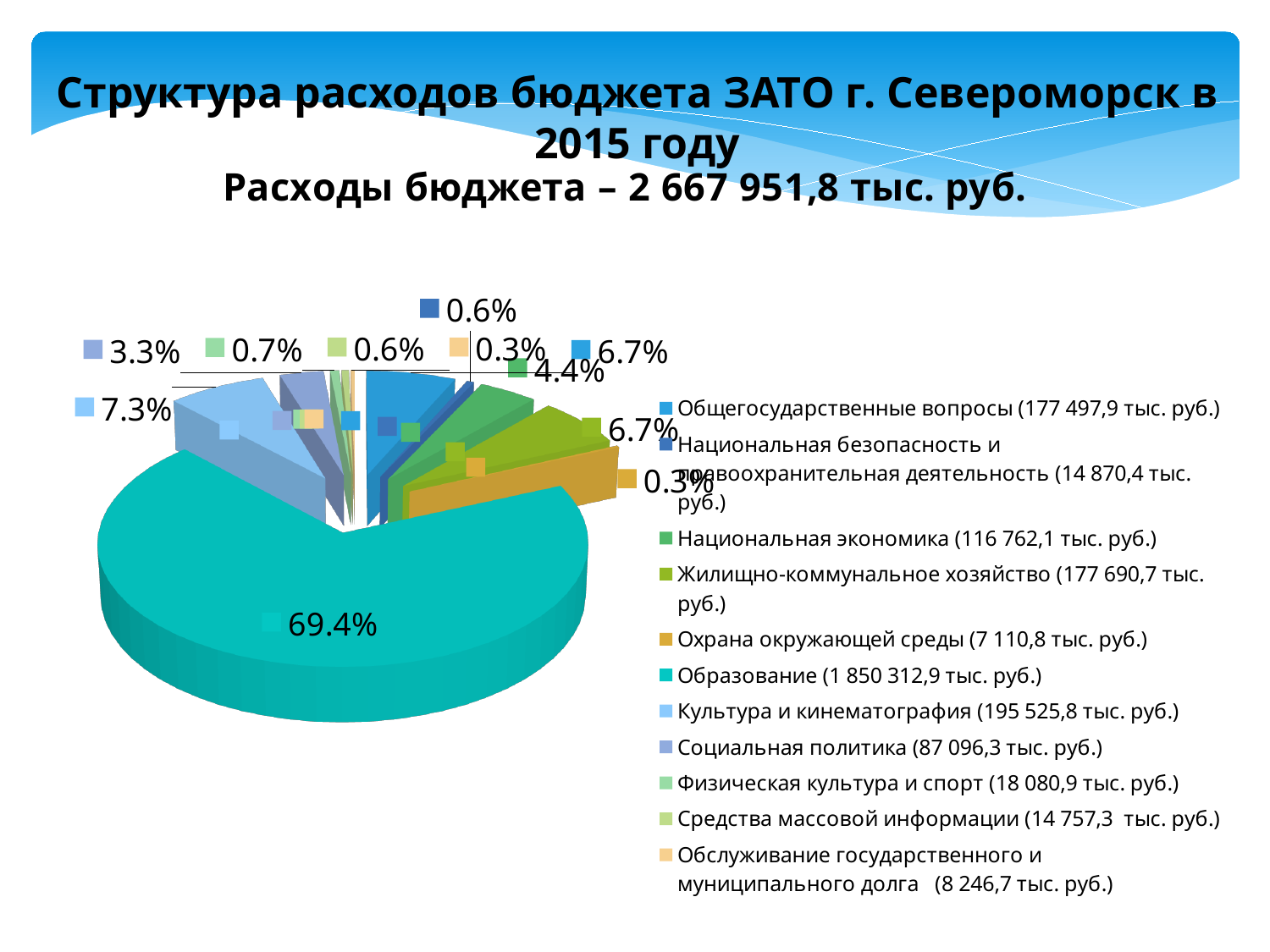
What year does the chart title refer to? 2015 What kind of chart is shown on the slide? pie chart What percentage share is shown for the largest slice of the pie chart? 69.4% Which category has the largest slice of the pie chart? Образование How many categories does the legend of the pie chart list? 11 Which is larger in the pie chart: the slice for Образование or the slice for Культура и кинематография? Образование Which category has a larger amount in the legend: Национальная экономика or Социальная политика? Национальная экономика What amount does the legend give for Культура и кинематография? 195 525,8 тыс. руб. What amount does the legend give for Охрана окружающей среды? 7 110,8 тыс. руб. What total budget expenditure is stated in the slide title? 2 667 951,8 тыс. руб. What share of the pie chart does Образование account for? 69.4% What amount does the legend give for Образование? 1 850 312,9 тыс. руб.